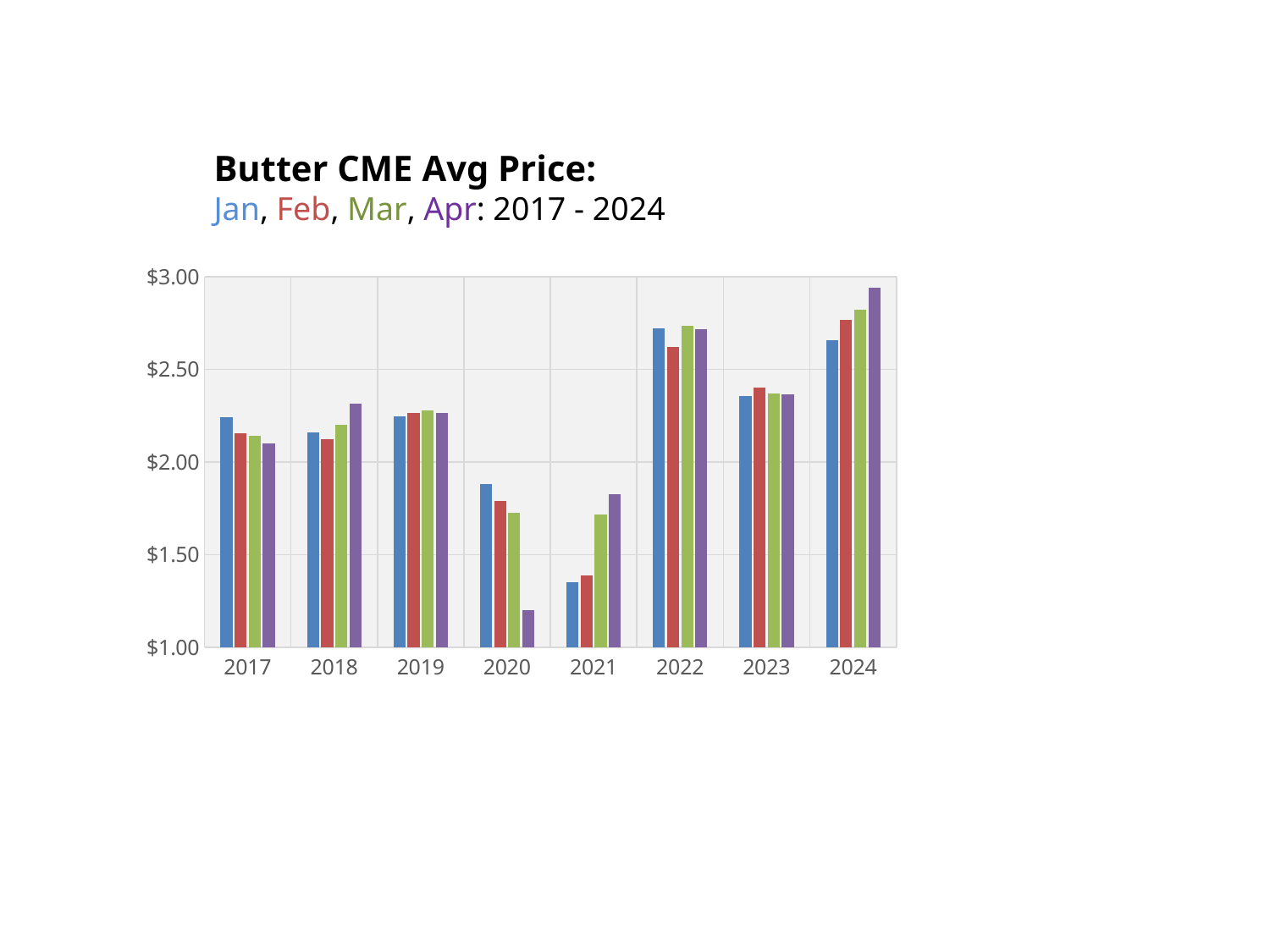
Which year and month has the highest butter price on the chart? Apr 2024 Is the Jan value for 2021 greater or less than $1.50? less Is the Jan value for 2022 greater or less than $2.50? greater How many years are shown along the x axis? 8 Which is larger, the Apr value for 2021 or the Apr value for 2020? Apr 2021 What kind of chart is shown on the slide? Bar chart Is the Apr value for 2020 greater or less than $1.50? less Which year and month has the lowest butter price on the chart? Apr 2020 How many months (series) does the chart show for each year? 4 Which colour represents the Apr series? Purple Within 2024, do the values rise or fall from Jan to Apr? Rise